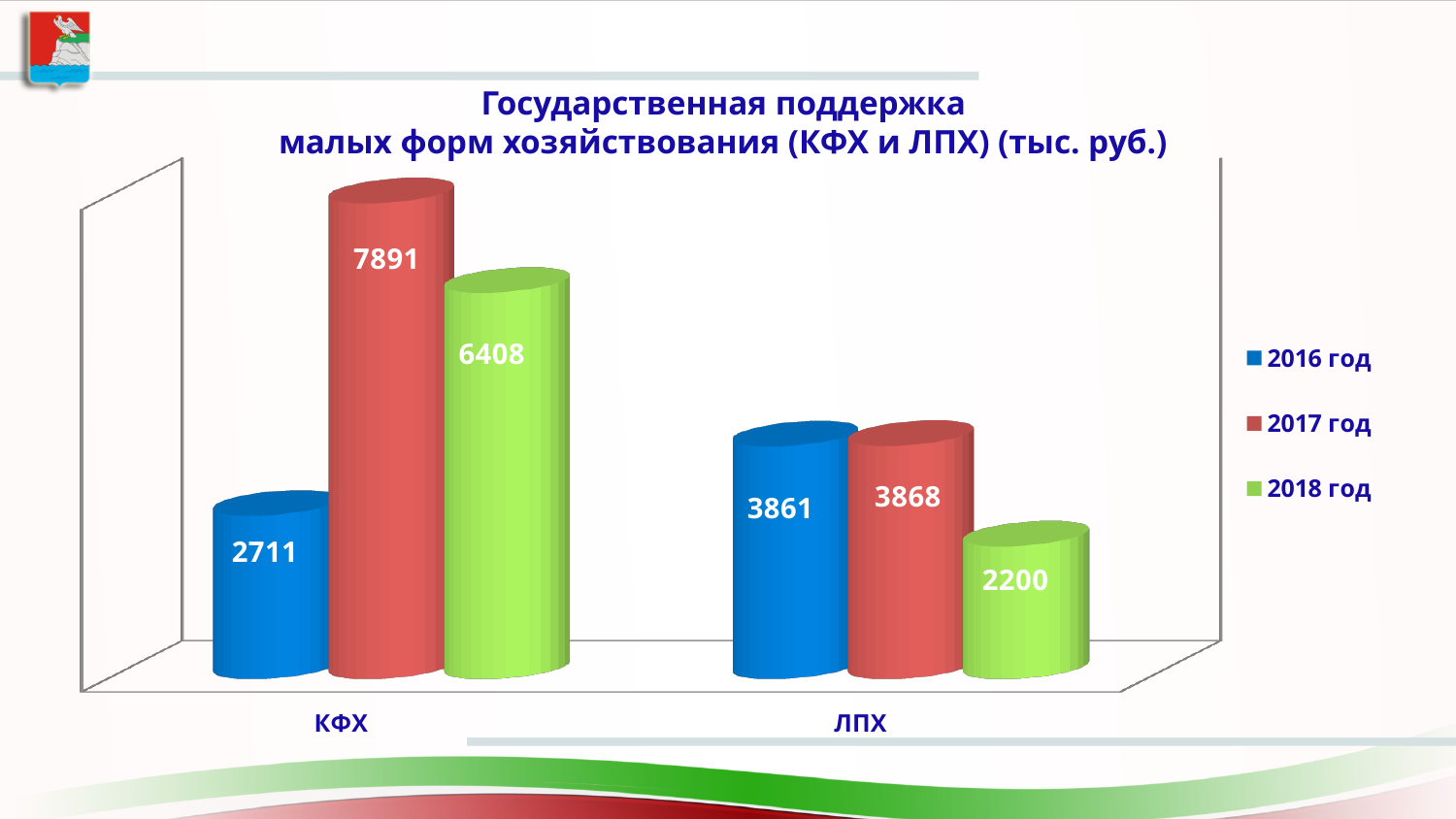
What is the difference between the 2017 год and 2018 год values for КФХ? 1483 How many categories are shown on the x axis? 2 What is the value for КФХ in 2017 год? 7891 Which is larger: the 2018 год value for КФХ or the 2018 год value for ЛПХ? КФХ What kind of chart is shown on the slide? Bar chart Which year has the highest value for КФХ? 2017 год What is the value for КФХ in 2016 год? 2711 Which year has the lowest value for ЛПХ? 2018 год What is the value for ЛПХ in 2016 год? 3861 What colour represents 2016 год in the chart? Blue What is the value for ЛПХ in 2018 год? 2200 How many series does the legend list? 3